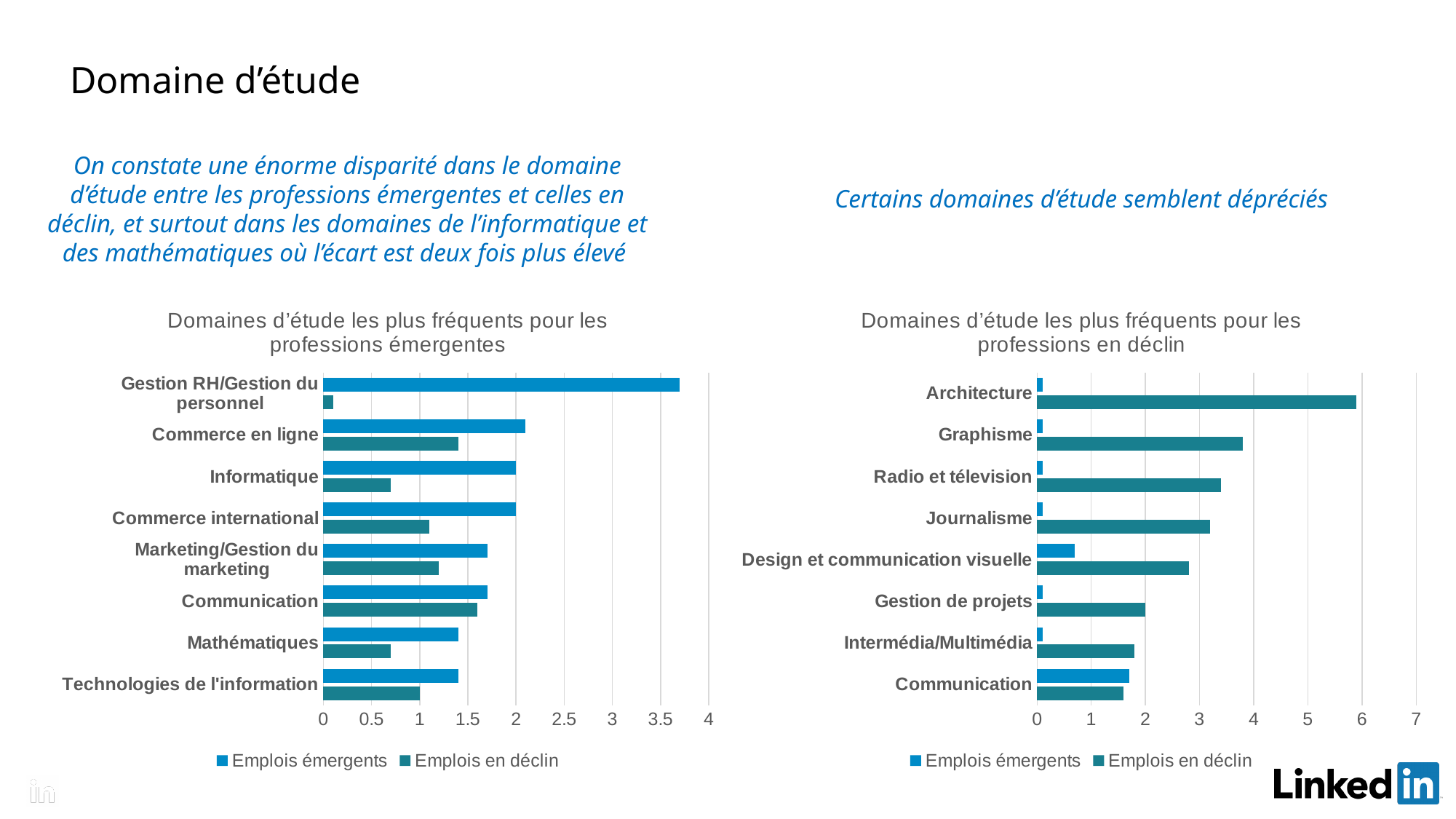
On the right chart, which is larger for Journalisme: the 'Emplois émergents' value or the 'Emplois en déclin' value? Emplois en déclin On the left chart, is the 'Emplois émergents' value for Gestion RH/Gestion du personnel greater or less than 3.5? greater On the left chart, which is larger for Informatique: the 'Emplois émergents' value or the 'Emplois en déclin' value? Emplois émergents What are the two legend entries on the left chart? Emplois émergents, Emplois en déclin On the right chart, is the 'Emplois en déclin' value for Graphisme greater or less than 4? less On the right chart, is the 'Emplois en déclin' value for Architecture greater or less than 5? greater On the right chart, which category has the highest 'Emplois en déclin' value? Architecture How many series does the legend list on the right chart, 'Domaines d'étude les plus fréquents pour les professions en déclin'? 2 On the left chart, which category has the highest 'Emplois émergents' value? Gestion RH/Gestion du personnel On the right chart, which category has the lowest 'Emplois en déclin' value? Communication What kind of chart is the left chart, 'Domaines d'étude les plus fréquents pour les professions émergentes'? bar chart How many categories are shown on the left chart, 'Domaines d'étude les plus fréquents pour les professions émergentes'? 8